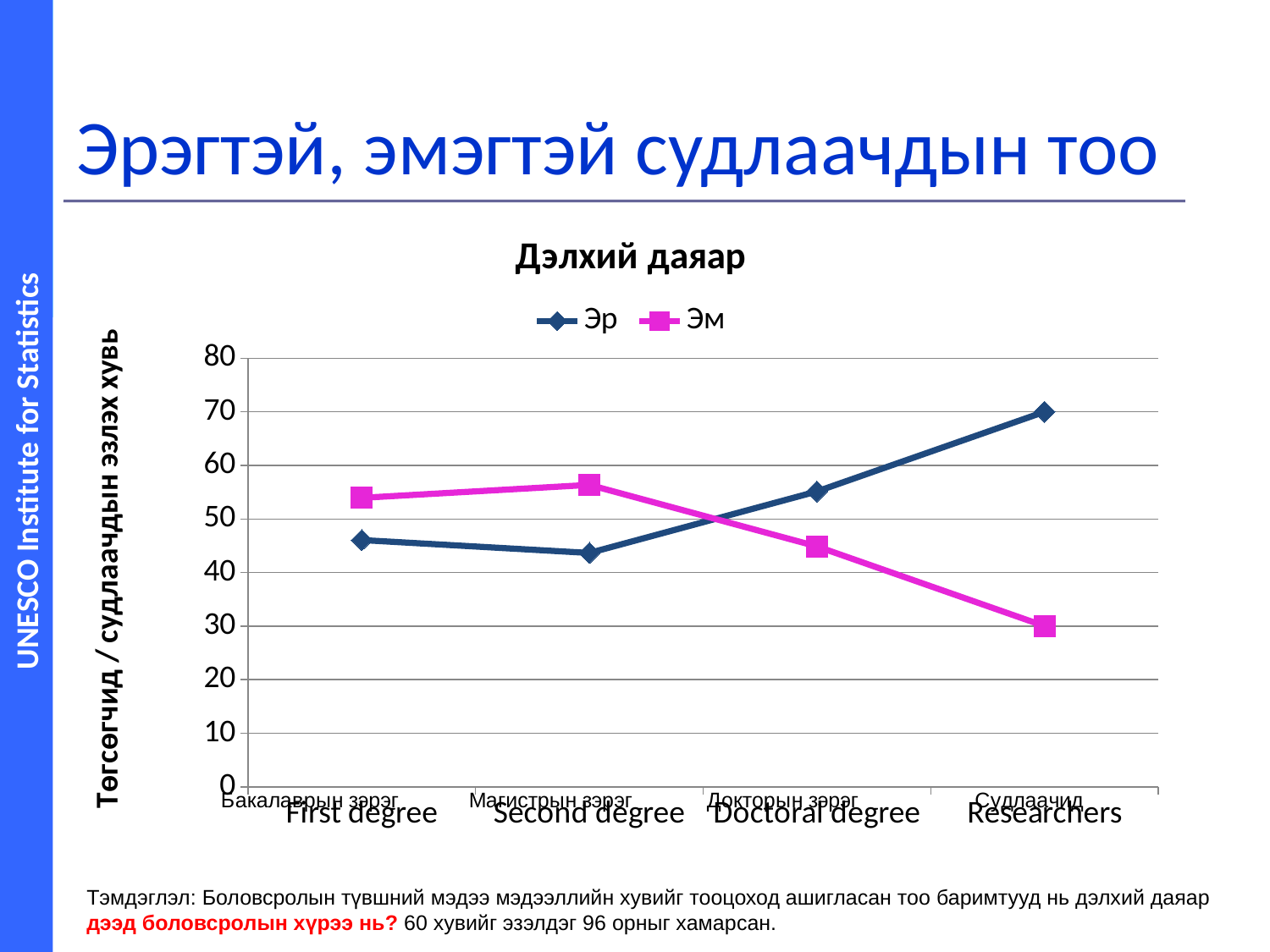
Is the Эр value for First degree greater or less than 50? less Is the Эр value for Researchers greater or less than 60? greater What is the title of the chart? Дэлхий даяар Does the Эм series rise or fall from Second degree to Researchers? fall How many series does the legend list? 2 Which series is drawn in magenta with square markers? Эм For which category is the Эм series lowest? Researchers What kind of chart is shown on the slide? line chart At Doctoral degree, which series has the larger value, Эр or Эм? Эр For which category is the Эр series highest? Researchers Is the Эм value for Researchers greater or less than 40? less How many categories are plotted along the x axis? 4